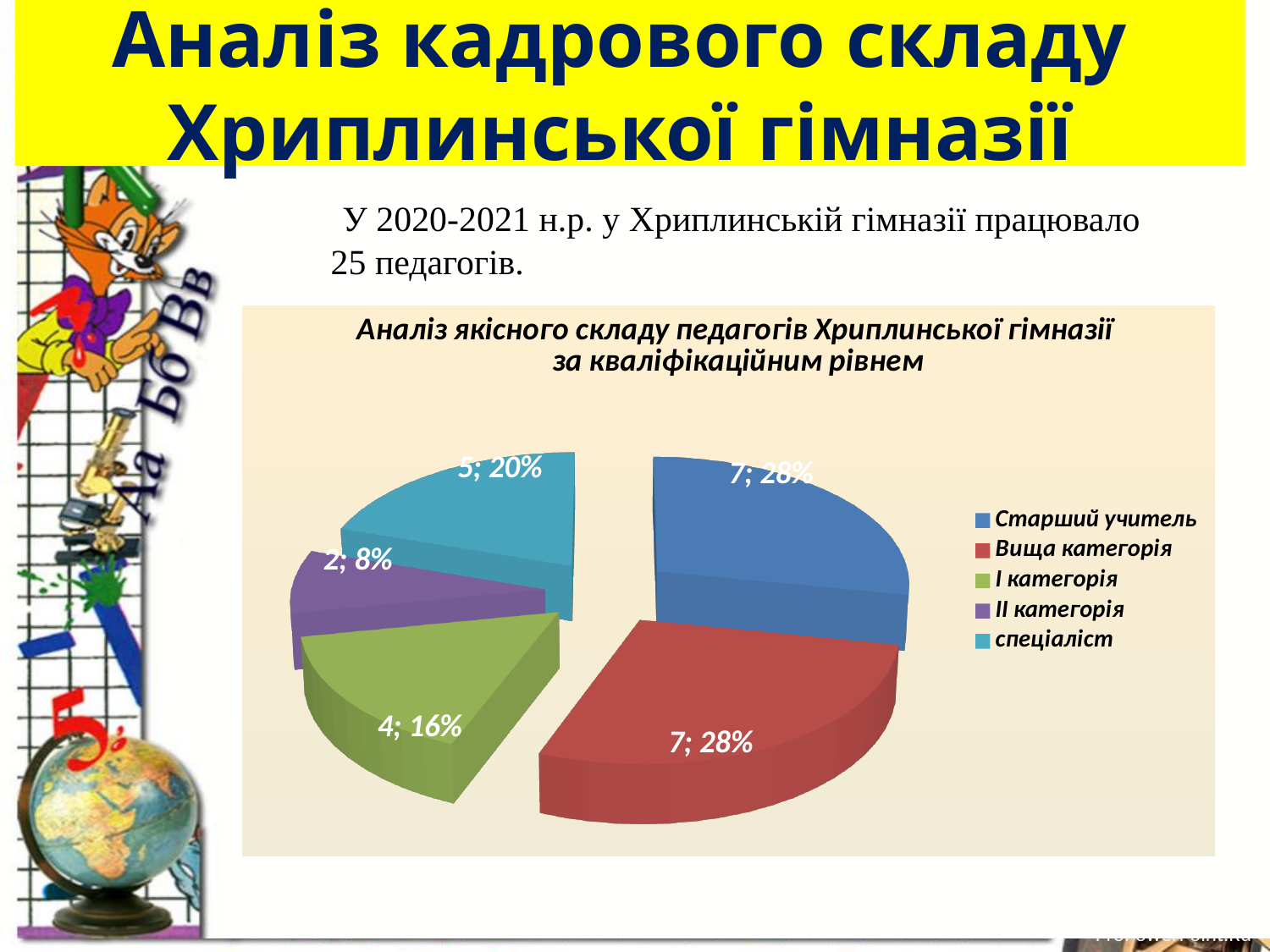
What share of the pie does the 'спеціаліст' slice represent? 20% What is the value shown for the 'Старший учитель' slice? 7; 28% How many categories does the legend of the pie chart list? 5 What kind of chart is shown on the slide? pie chart What is the value shown for the 'спеціаліст' slice? 5; 20% Which is larger, the 'спеціаліст' slice or the 'І категорія' slice? спеціаліст What is the value shown for the 'І категорія' slice? 4; 16% What is the title of the pie chart? Аналіз якісного складу педагогів Хриплинської гімназії за кваліфікаційним рівнем What is the difference in count between the 'Старший учитель' slice and the 'ІІ категорія' slice? 5 Which category has the smallest slice of the pie? ІІ категорія What is the value shown for the 'ІІ категорія' slice? 2; 8% What is the value shown for the 'Вища категорія' slice? 7; 28%